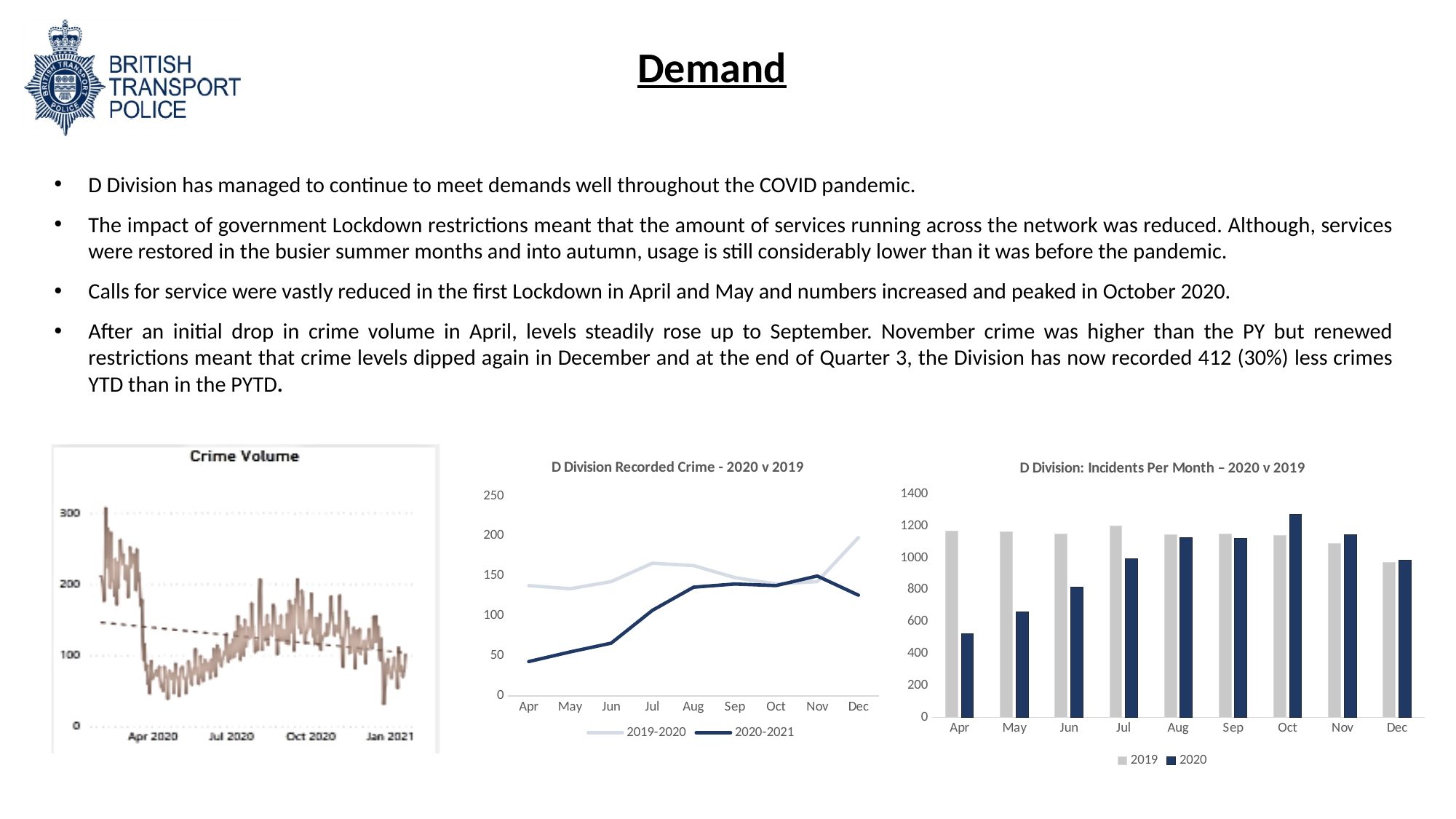
In the 'D Division: Incidents Per Month – 2020 v 2019' chart, is the value for 2020 in Apr greater or less than 600? less In the 'D Division: Incidents Per Month – 2020 v 2019' chart, which month has the lowest value for 2020? Apr In the 'D Division: Incidents Per Month – 2020 v 2019' chart, how many months are shown on the x axis? 9 In the 'D Division Recorded Crime - 2020 v 2019' chart, which month has the lowest value for the 2020-2021 series? Apr What kind of chart is the 'D Division: Incidents Per Month – 2020 v 2019' chart? bar chart What kind of chart is the 'D Division Recorded Crime - 2020 v 2019' chart? line chart In the 'D Division: Incidents Per Month – 2020 v 2019' chart, which is larger in Oct, the 2019 value or the 2020 value? 2020 In the 'D Division Recorded Crime - 2020 v 2019' chart, is the value for the 2020-2021 series in Apr greater or less than 100? less In the 'D Division Recorded Crime - 2020 v 2019' chart, which month has the highest value for the 2019-2020 series? Dec In the 'D Division Recorded Crime - 2020 v 2019' chart, does the 2020-2021 series rise or fall from Apr to Nov? rise In the 'D Division Recorded Crime - 2020 v 2019' chart, how many series does the legend list? 2 In the 'D Division: Incidents Per Month – 2020 v 2019' chart, which month has the highest value for 2020? Oct